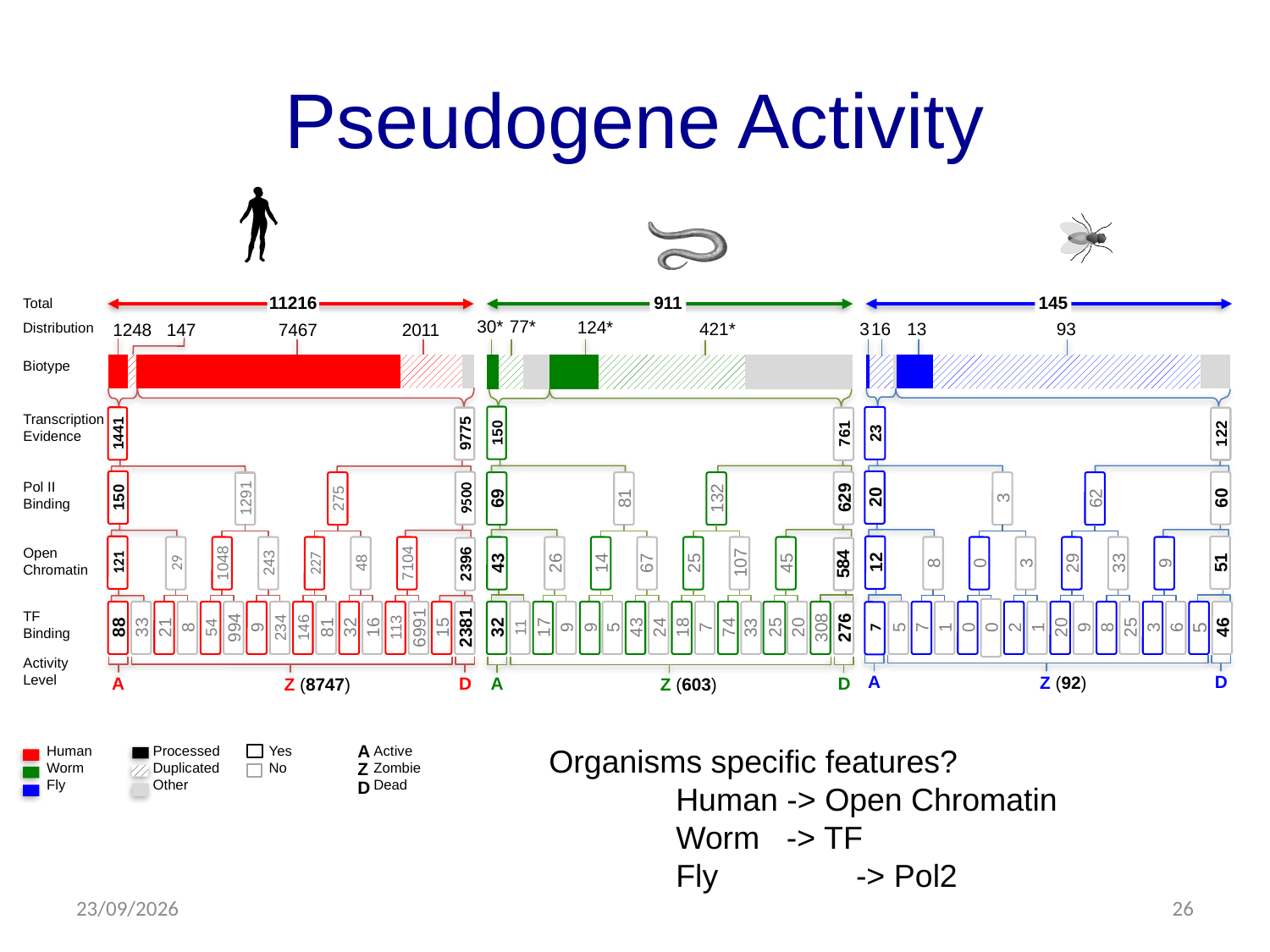
Which is larger: the number of Active human pseudogenes (88) or the number of Active worm pseudogenes (32)? Active human pseudogenes (88) How many human pseudogenes are labelled as Zombie (Z) at the Activity Level row? 8747 What is the total number of pseudogenes shown for the fly? 145 What is the difference between the human total (11216) and the worm total (911)? 10305 According to the legend, which colour represents the worm? Green How many fly pseudogenes are labelled as Active (A) at the Activity Level row? 7 How many worm pseudogenes are labelled as Dead (D) at the Activity Level row? 276 Which organism has the highest total number of pseudogenes? Human How many organisms are compared in the diagram? 3 Which organism has the lowest total number of pseudogenes? Fly What is the total number of pseudogenes shown for the human? 11216 What is the total number of pseudogenes shown for the worm? 911